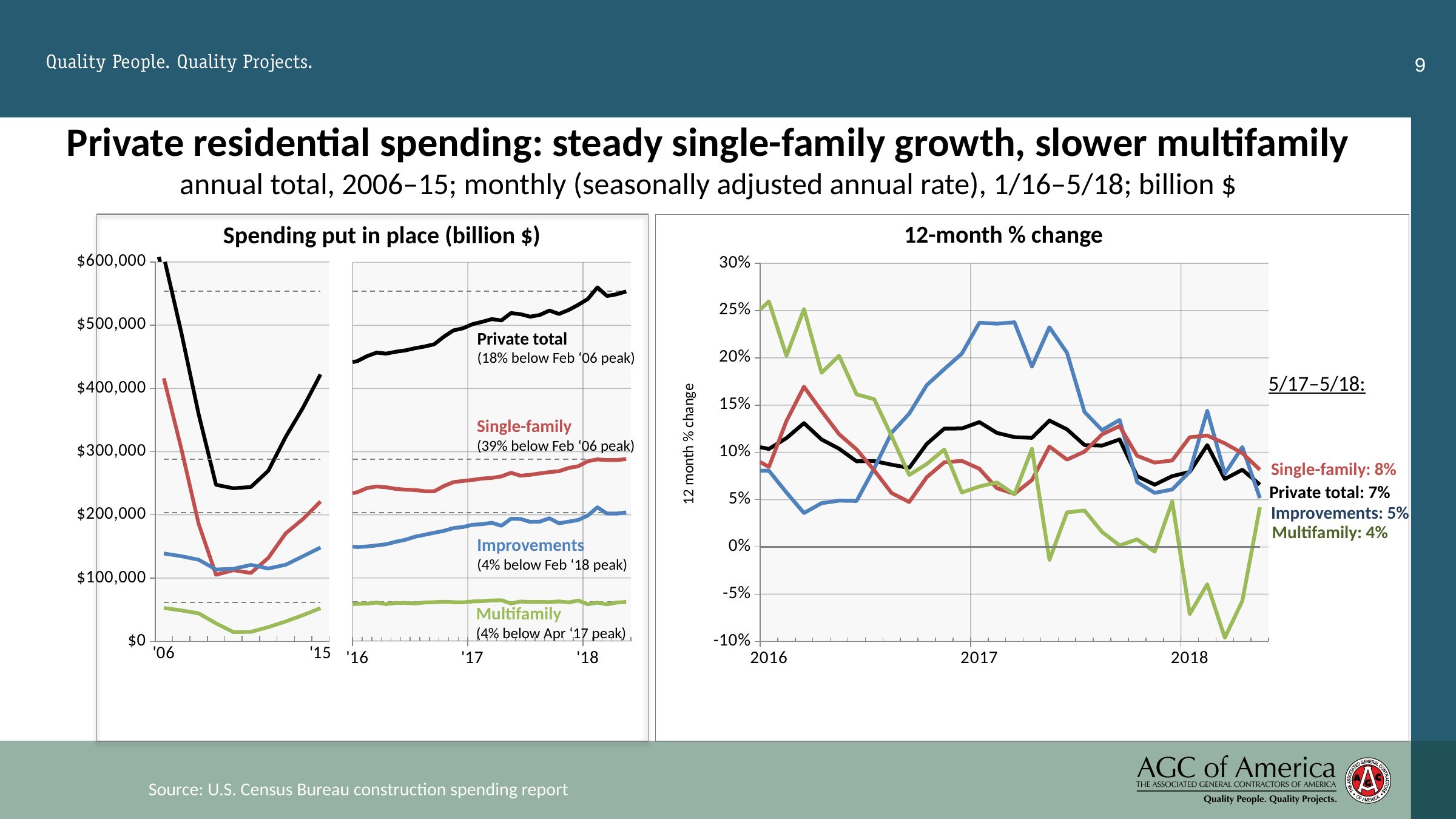
In the 12-month % change chart, what is the 12-month % change for Private total over 5/17–5/18? 7% In the 12-month % change chart, what is the difference between the 5/17–5/18 change for Single-family and for Multifamily? 4 percentage points In the 12-month % change chart, which has the larger 5/17–5/18 change, Private total or Improvements? Private total In the 12-month % change chart, what is the 12-month % change for Single-family over 5/17–5/18? 8% In the 12-month % change chart, what is the 12-month % change for Multifamily over 5/17–5/18? 4% In the 12-month % change chart, what is the 12-month % change for Improvements over 5/17–5/18? 5% In the 12-month % change chart, which series has the lowest 12-month % change for 5/17–5/18? Multifamily In the 12-month % change chart, which series has the highest 12-month % change for 5/17–5/18? Single-family In the Spending put in place chart, is the Private total value for '06 greater or less than $500,000? greater In the Spending put in place chart, is the Multifamily value for '15 greater or less than $100,000? less What kind of chart is the Spending put in place (billion $) chart? Line chart In the Spending put in place chart, how far below its Feb '06 peak is Single-family spending, according to the label? 39% below